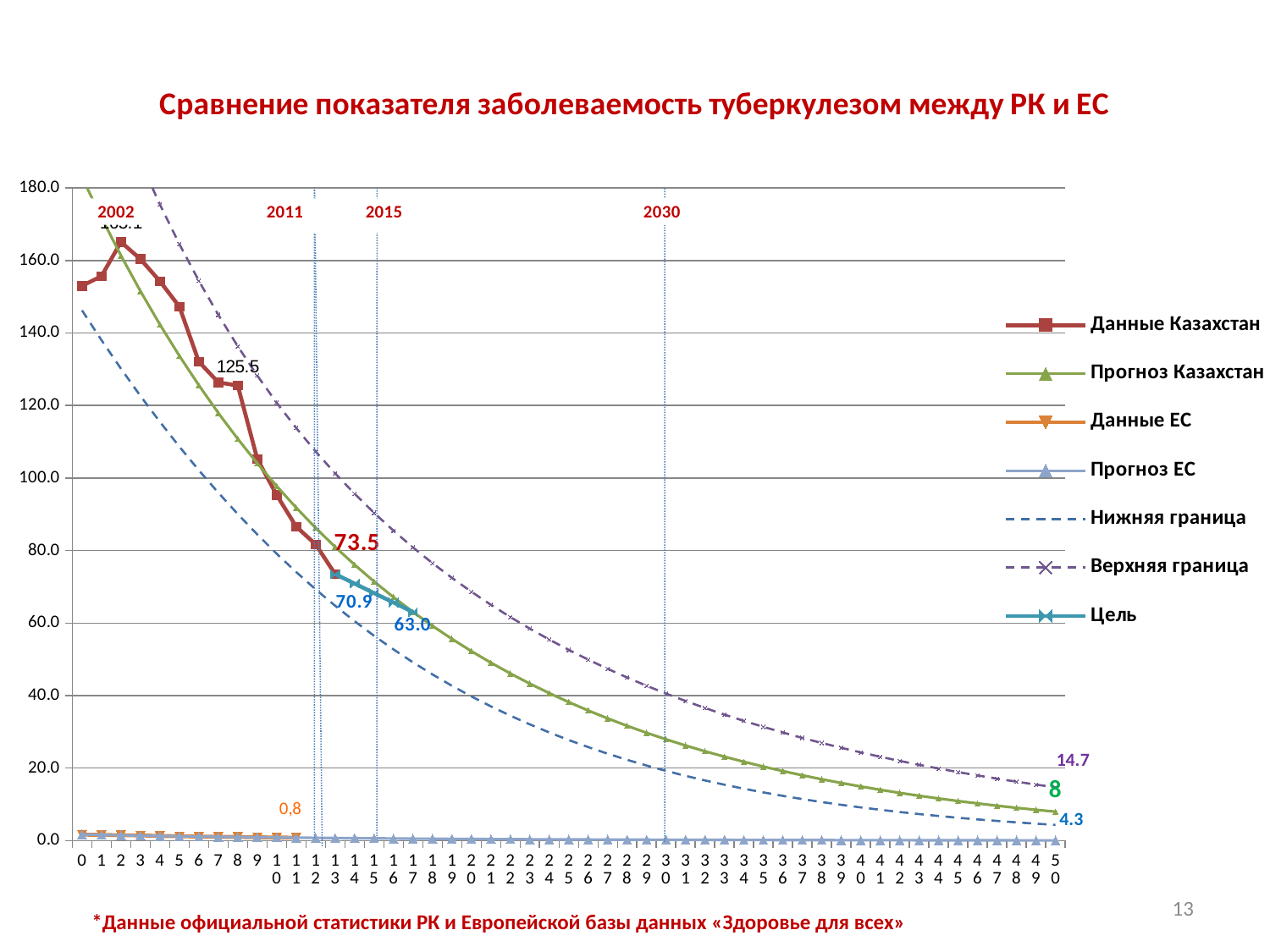
Is the value of Данные Казахстан at x = 0 greater or less than 140? greater How many series does the legend list? 7 What is the labelled value of the Прогноз Казахстан series at the right end of the chart (x = 50)? 8 What kind of chart is shown on the slide? line chart What is the labelled value of the Верхняя граница series at the right end of the chart (x = 50)? 14.7 What value is labelled on the Данные Казахстан series at x = 8? 125.5 What is the title of the chart? Сравнение показателя заболеваемость туберкулезом между РК и ЕС What value is labelled on the Данные ЕС series? 0,8 At x = 50, which is larger: Верхняя граница or Нижняя граница? Верхняя граница What is the difference between the labelled values of Верхняя граница (14.7) and Нижняя граница (4.3) at x = 50? 10.4 What is the labelled value of the Нижняя граница series at the right end of the chart (x = 50)? 4.3 What is the labelled end value of the Цель series? 63.0